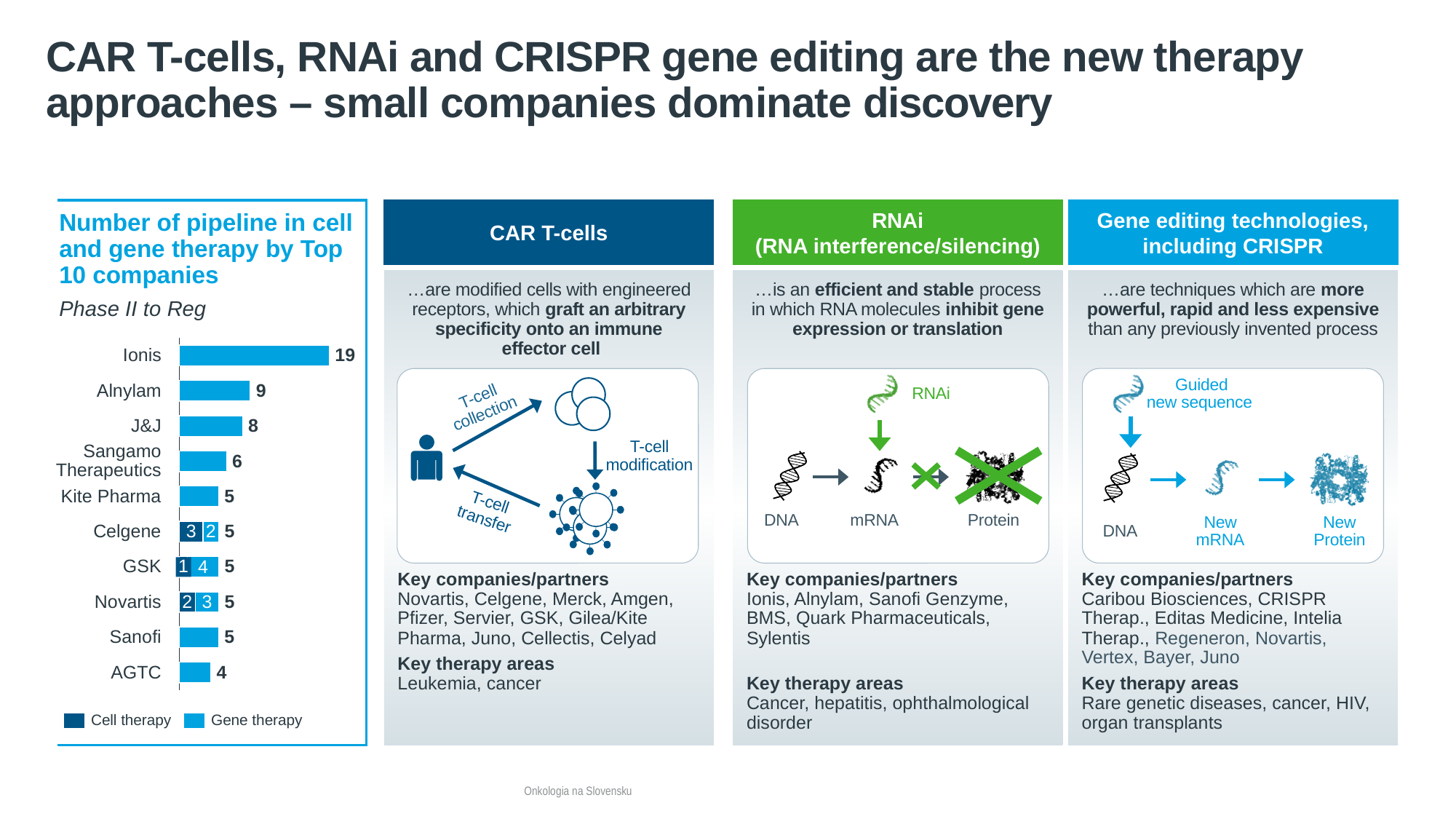
What is the total number of pipeline projects shown for Ionis? 19 What is the total of the stacked bar for Novartis? 5 How many series does the chart legend list? 2 Which company has the lowest number of pipeline projects? AGTC How many companies are shown in the chart? 10 What type of chart is used to show the number of pipeline projects by company? Bar chart What is the difference between the values for Ionis and Alnylam? 10 What is the value shown for Alnylam? 9 How many gene therapy pipeline projects does GSK have? 4 Which has a larger value, J&J or Sangamo Therapeutics? J&J How many cell therapy pipeline projects does Celgene have? 3 Which company has the highest number of pipeline projects? Ionis